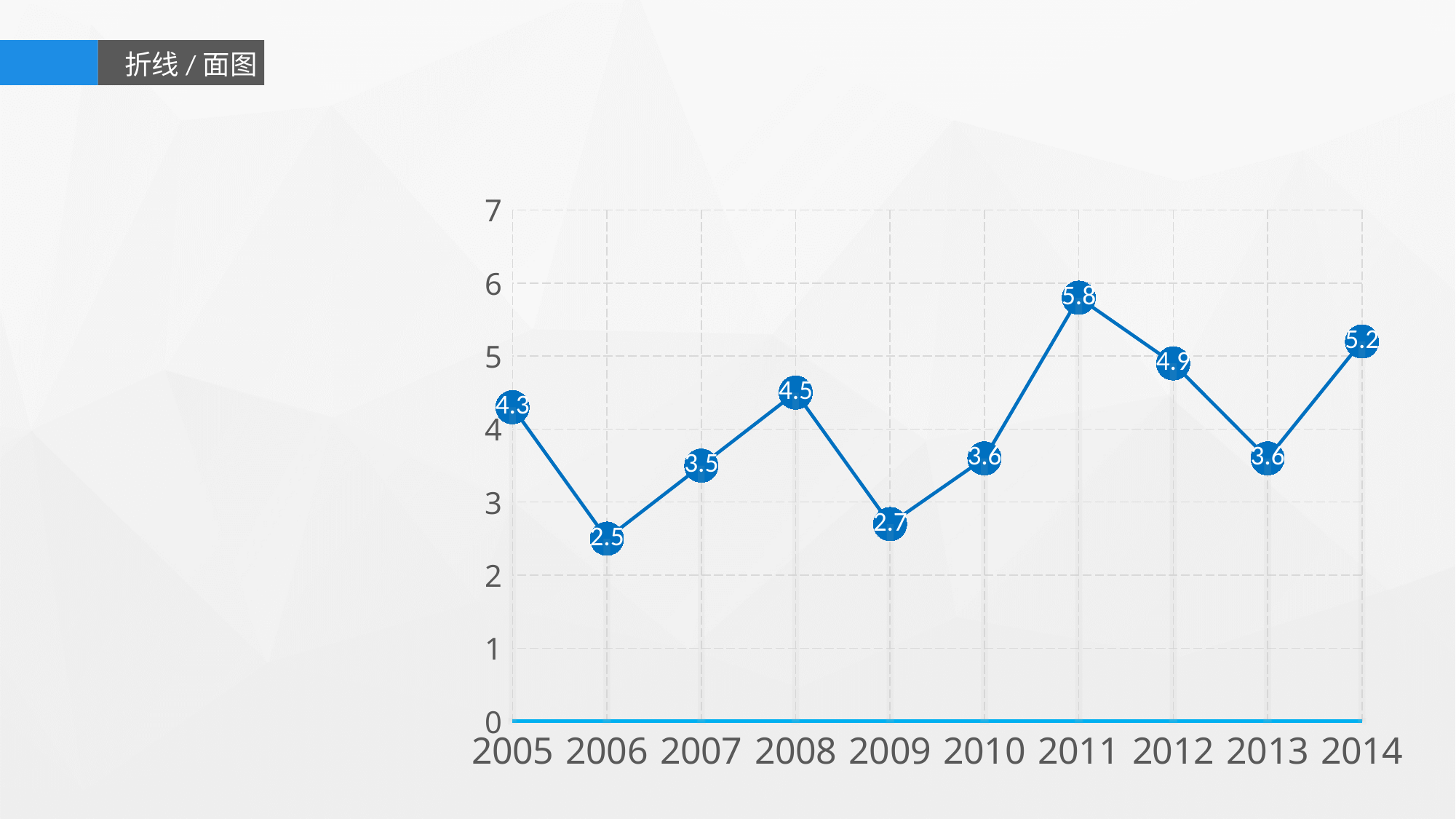
What is the value for 2009? 2.7 Which is larger, the value for 2012 or the value for 2008? 2012 Which year has the lowest value? 2006 What is the value for 2011? 5.8 What kind of chart is shown on the slide? line chart Is the value for 2014 greater or less than 5? greater Does the value rise or fall from 2012 to 2013? fall What is the value for 2005? 4.3 What is the difference between the values for 2011 and 2006? 3.3 Which year has the highest value? 2011 What is the difference between the values for 2014 and 2013? 1.6 How many years are plotted on the x axis? 10